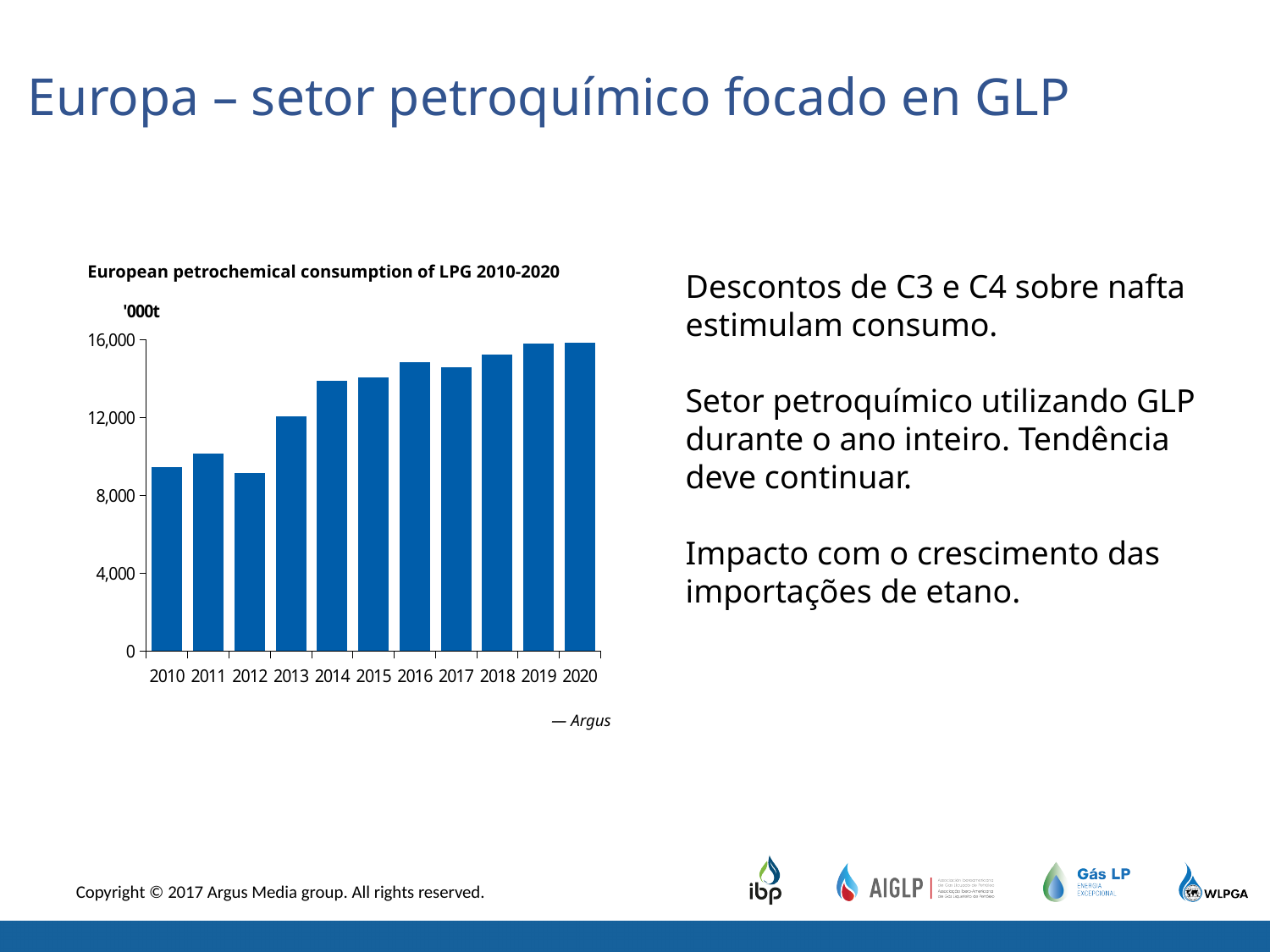
Which year has the larger value, 2010 or 2018? 2018 Is the value for 2010 greater or less than 8,000? greater Is the value for 2011 greater or less than 12,000? less How many years are plotted in the chart? 11 Overall, do the values rise or fall from 2010 to 2020? rise Is the value for 2014 greater or less than 12,000? greater What is the title of the chart? European petrochemical consumption of LPG 2010-2020 What unit is shown on the chart's vertical axis? '000t Which year has the lowest European petrochemical consumption of LPG? 2012 Which year has the larger value, 2012 or 2013? 2013 What kind of chart is shown on the slide? bar chart